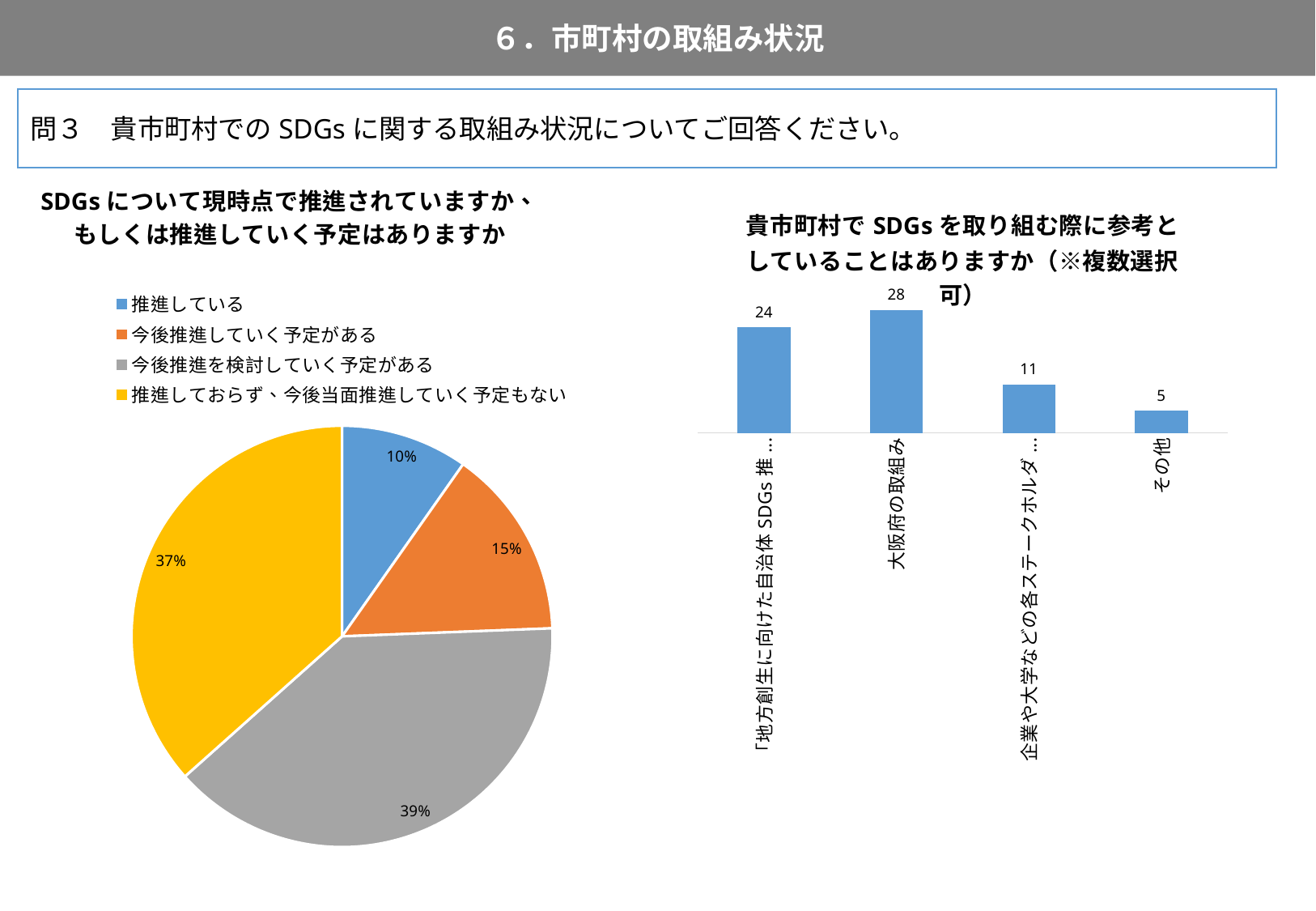
In the bar chart on the right, what is the value for 大阪府の取組み? 28 In the pie chart on the left, what percentage is shown for 推進している? 10% What type of chart is shown on the right side of the slide? Bar chart In the pie chart on the left, what percentage is shown for 推進しておらず、今後当面推進していく予定もない? 37% In the pie chart on the left, which category has the smallest share? 推進している In the bar chart on the right, what is the value for その他? 5 In the pie chart on the left, what colour is the slice for 今後推進していく予定がある? Orange In the pie chart on the left, what is the difference in percentage points between 今後推進していく予定がある and 推進している? 5 In the bar chart on the right, what is the difference between the first bar (24) and 大阪府の取組み? 4 In the pie chart on the left, what percentage is shown for 今後推進を検討していく予定がある? 39% In the pie chart on the left, how many categories does the legend list? 4 In the bar chart on the right, which category has the highest value? 大阪府の取組み